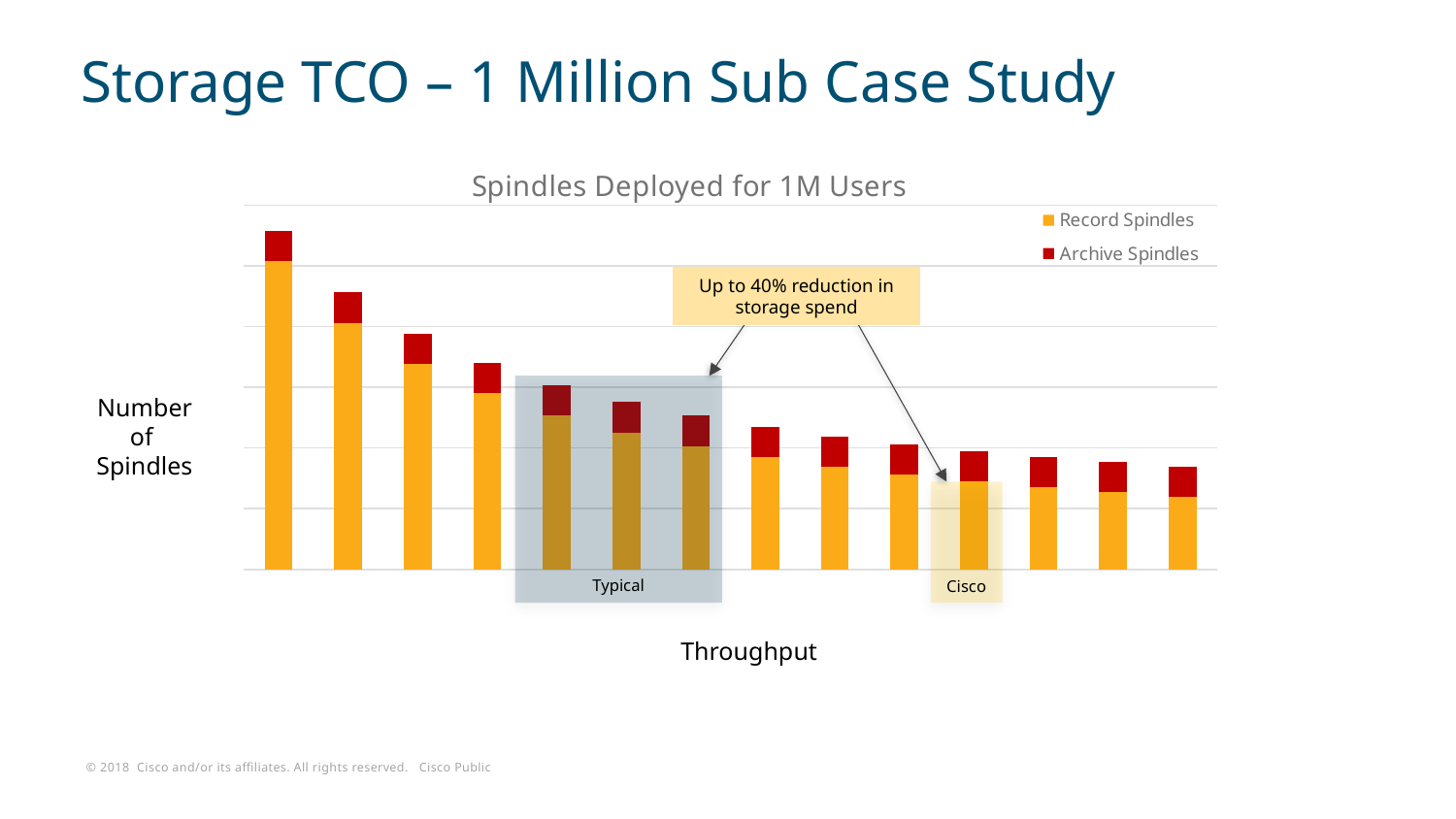
How many bars are plotted in the 'Spindles Deployed for 1M Users' chart? 14 What are the two series named in the chart legend? Record Spindles and Archive Spindles What is the title of the chart? Spindles Deployed for 1M Users What kind of chart is shown on the slide? Stacked bar chart Do the bar heights rise or fall moving from left to right along the Throughput axis? Fall How many series does the legend of the 'Spindles Deployed for 1M Users' chart list? 2 How many bars are inside the shaded group labelled 'Typical'? 3 Which bar in the chart is the tallest? The leftmost bar Is the bar labelled 'Cisco' taller or shorter than the bars in the 'Typical' group? Shorter Is the leftmost bar taller or shorter than the rightmost bar? Taller